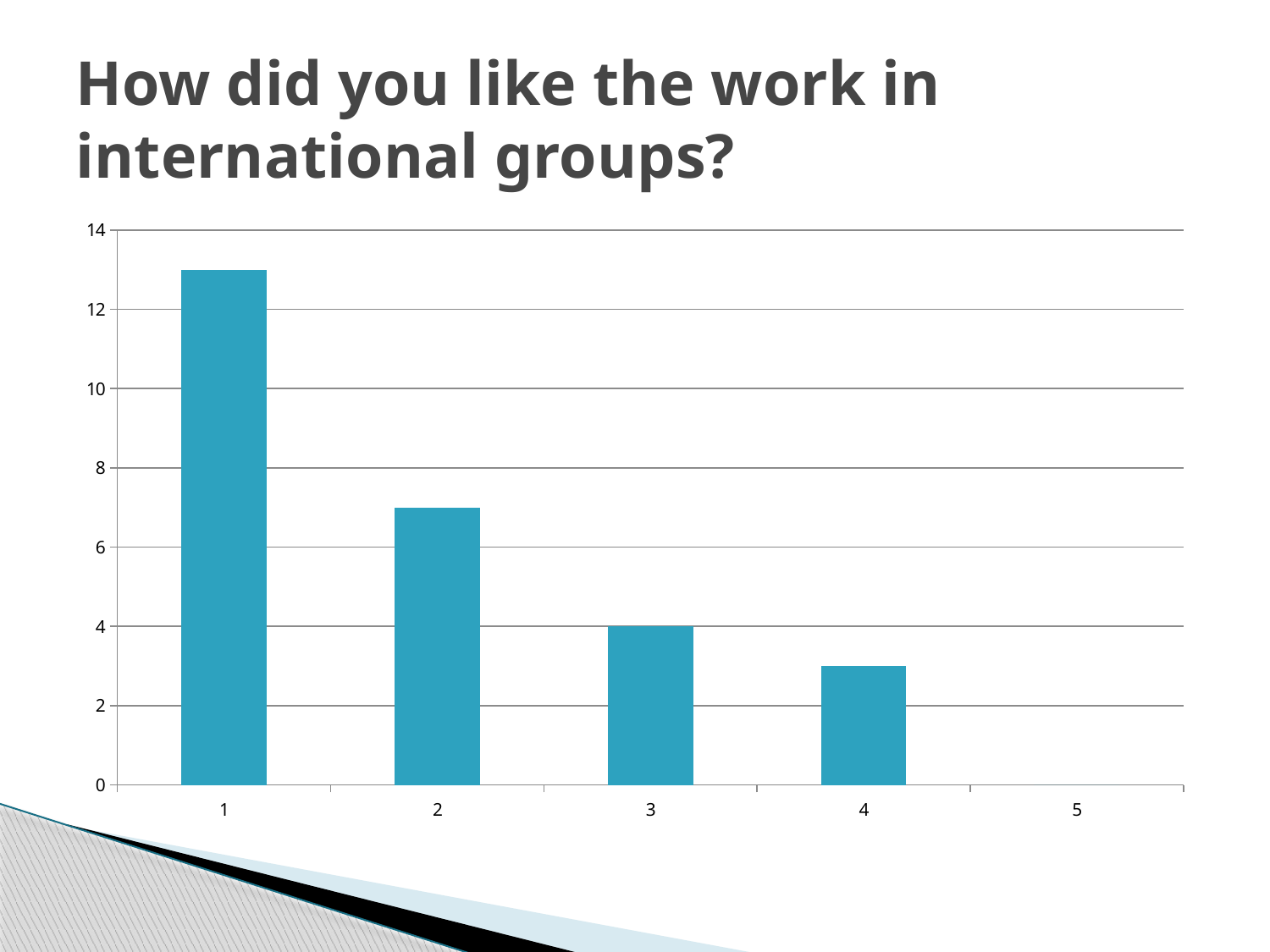
Which category has the lowest value? 5 How many categories are shown on the x axis? 5 Is the value for category 4 greater or less than 4? less Which category has the highest value? 1 Is the value for category 1 greater or less than 12? greater Is the value for category 2 greater or less than 8? less What kind of chart is shown on the slide? bar chart What is the value for category 5? 0 Which is larger, the value for category 1 or the value for category 2? category 1 Do the values rise or fall from category 1 to category 5? fall What is the value for category 3? 4 What is the title of the chart on the slide? How did you like the work in international groups?